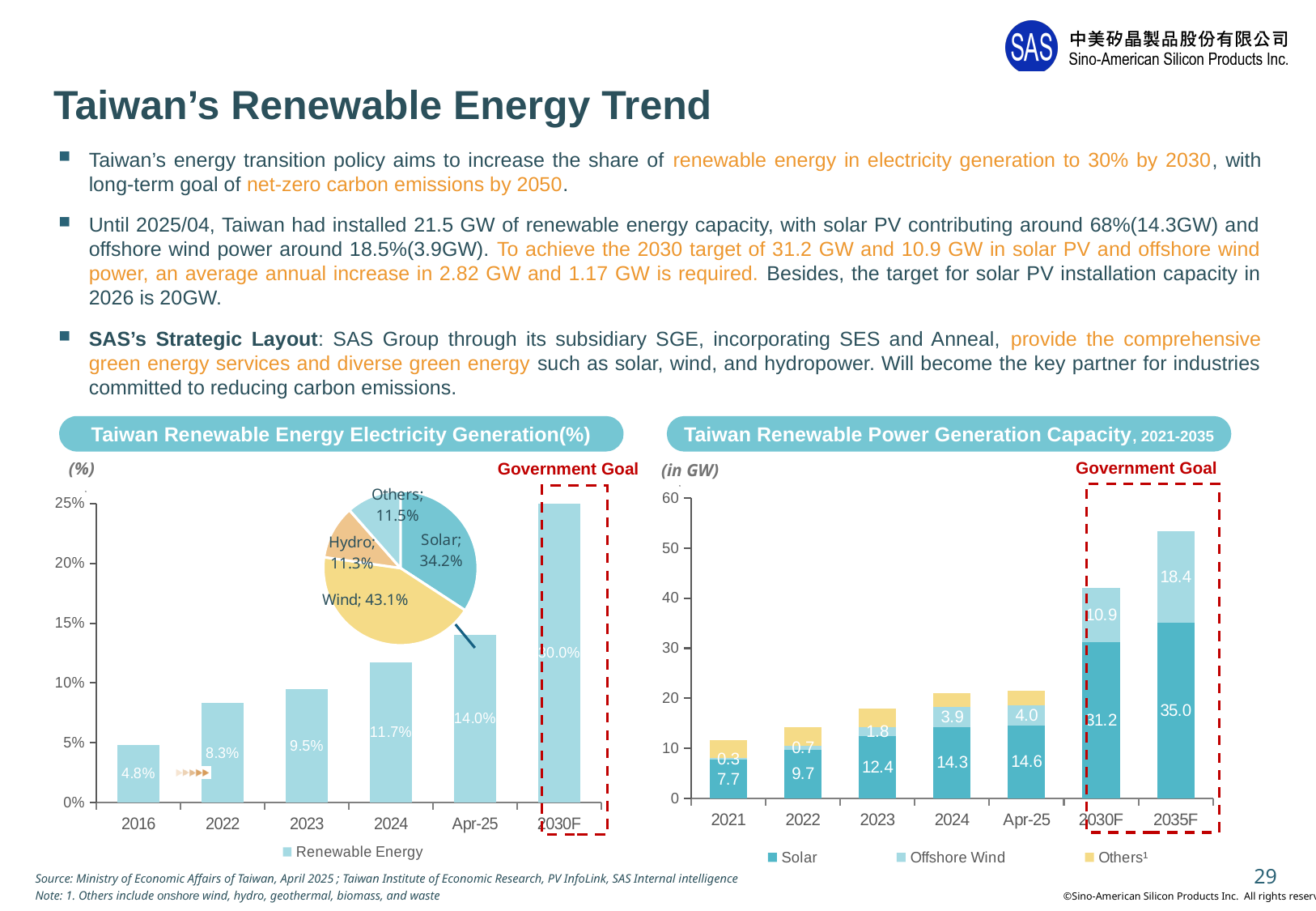
In the Taiwan Renewable Power Generation Capacity, 2021-2035 chart, what is the Solar value for 2030F? 31.2 What kind of chart is the Taiwan Renewable Power Generation Capacity, 2021-2035 chart? stacked bar chart In the Taiwan Renewable Energy Electricity Generation(%) chart, what is the value for 2024? 11.7% In the Taiwan Renewable Energy Electricity Generation(%) chart, do the bar values rise or fall from 2016 to 2030F? rise In the Taiwan Renewable Energy Electricity Generation(%) chart, is the value for 2030F greater or less than 25%? greater In the Taiwan Renewable Energy Electricity Generation(%) chart, what is the difference between the 2022 and 2016 values? 3.5% In the Taiwan Renewable Power Generation Capacity, 2021-2035 chart, which is larger: the Solar value for 2035F or the Solar value for 2030F? 2035F In the Taiwan Renewable Energy Electricity Generation(%) chart, what is the value for Apr-25? 14.0% In the Taiwan Renewable Power Generation Capacity, 2021-2035 chart, what is the Offshore Wind value for 2024? 3.9 In the pie chart inset on the Taiwan Renewable Energy Electricity Generation(%) chart, which slice is the smallest? Hydro In the Taiwan Renewable Power Generation Capacity, 2021-2035 chart, how many series does the legend list? 3 In the pie chart inset on the Taiwan Renewable Energy Electricity Generation(%) chart, what share does Wind have? 43.1%